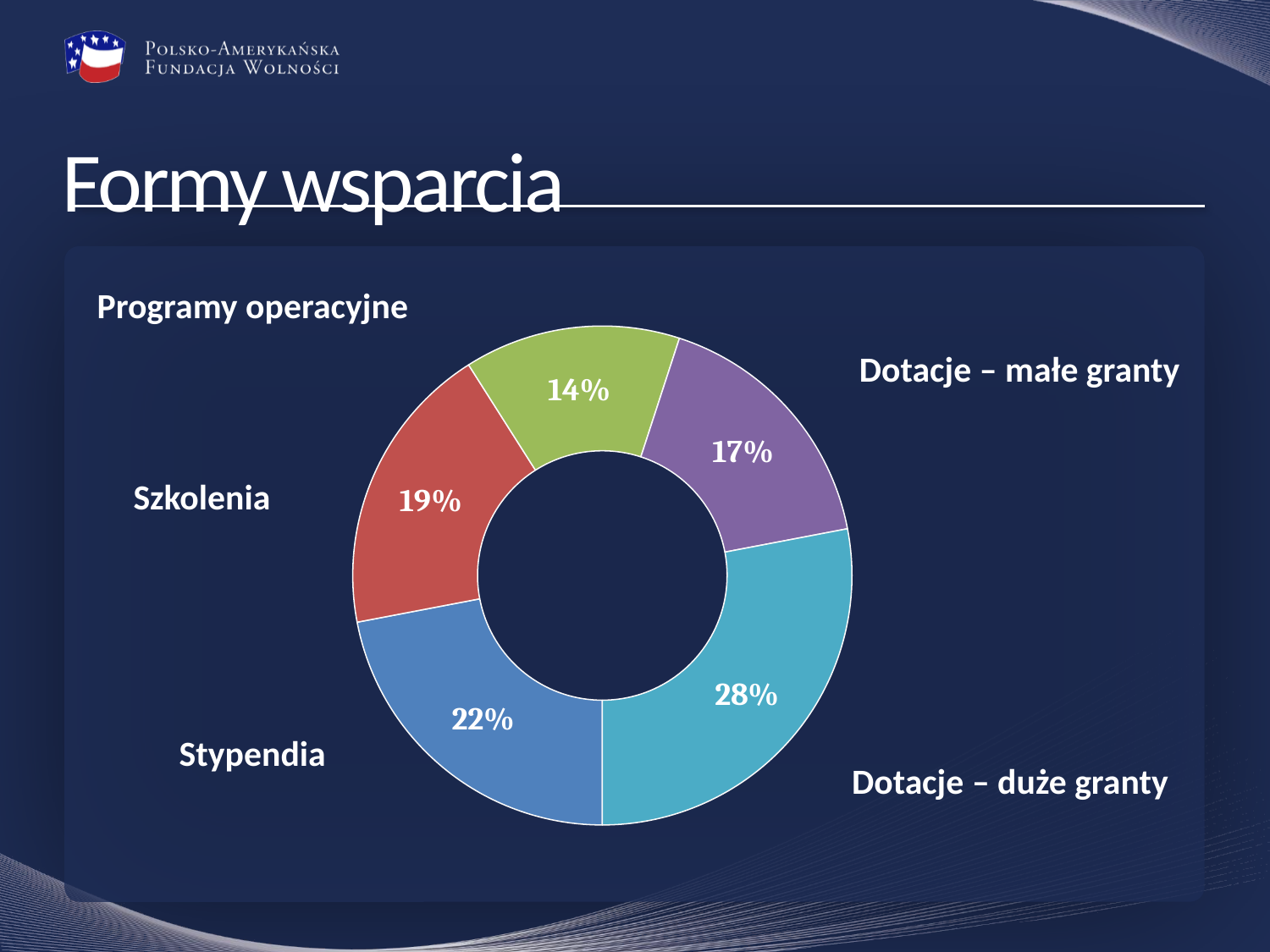
Which category has the largest share of the chart? Dotacje – duże granty What percentage is shown for Programy operacyjne? 14% What percentage is shown for Stypendia? 22% What is the difference in percentage points between Dotacje – duże granty and Dotacje – małe granty? 11 What kind of chart is shown on the slide? Doughnut chart What percentage is shown for Szkolenia? 19% What is the title of the slide containing the chart? Formy wsparcia How many categories are shown in the chart? 5 Which is larger, the share for Stypendia or the share for Szkolenia? Stypendia What colour is the segment for Szkolenia? Red Which category has the smallest share of the chart? Programy operacyjne What share of the chart does Dotacje – duże granty represent? 28%